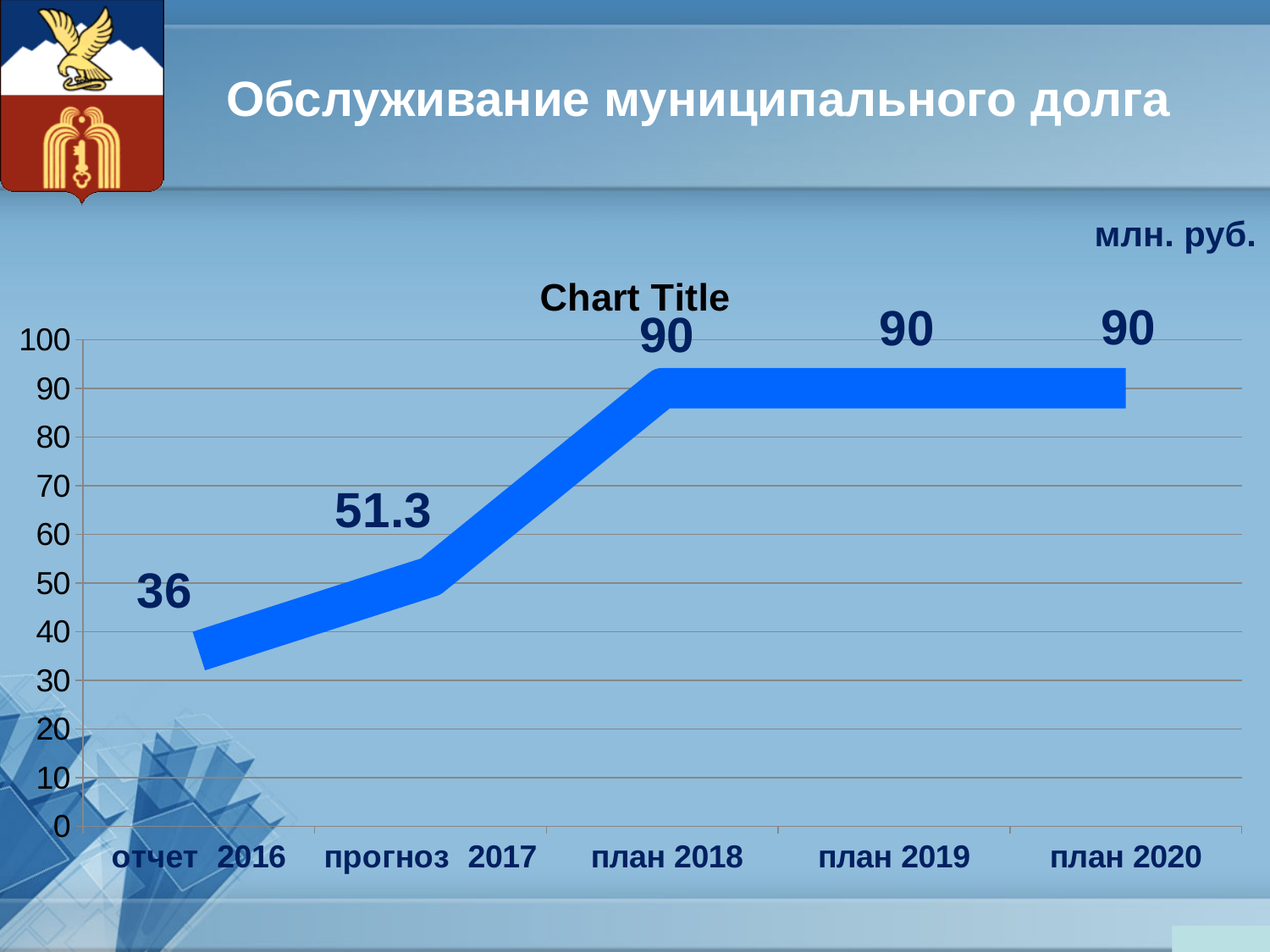
What is the value for план 2020? 90 Is the value for прогноз 2017 greater or less than 40? greater How many categories are shown on the x axis? 5 What is the value for план 2018? 90 What is the difference between the values for план 2018 and отчет 2016? 54 What kind of chart is shown on the slide? line chart Which is larger, the value for прогноз 2017 or the value for план 2019? план 2019 What is the value for отчет 2016? 36 What is the difference between the values for прогноз 2017 and отчет 2016? 15.3 Do the values rise or fall from отчет 2016 to план 2018? rise Which category has the lowest value? отчет 2016 What is the value for прогноз 2017? 51.3